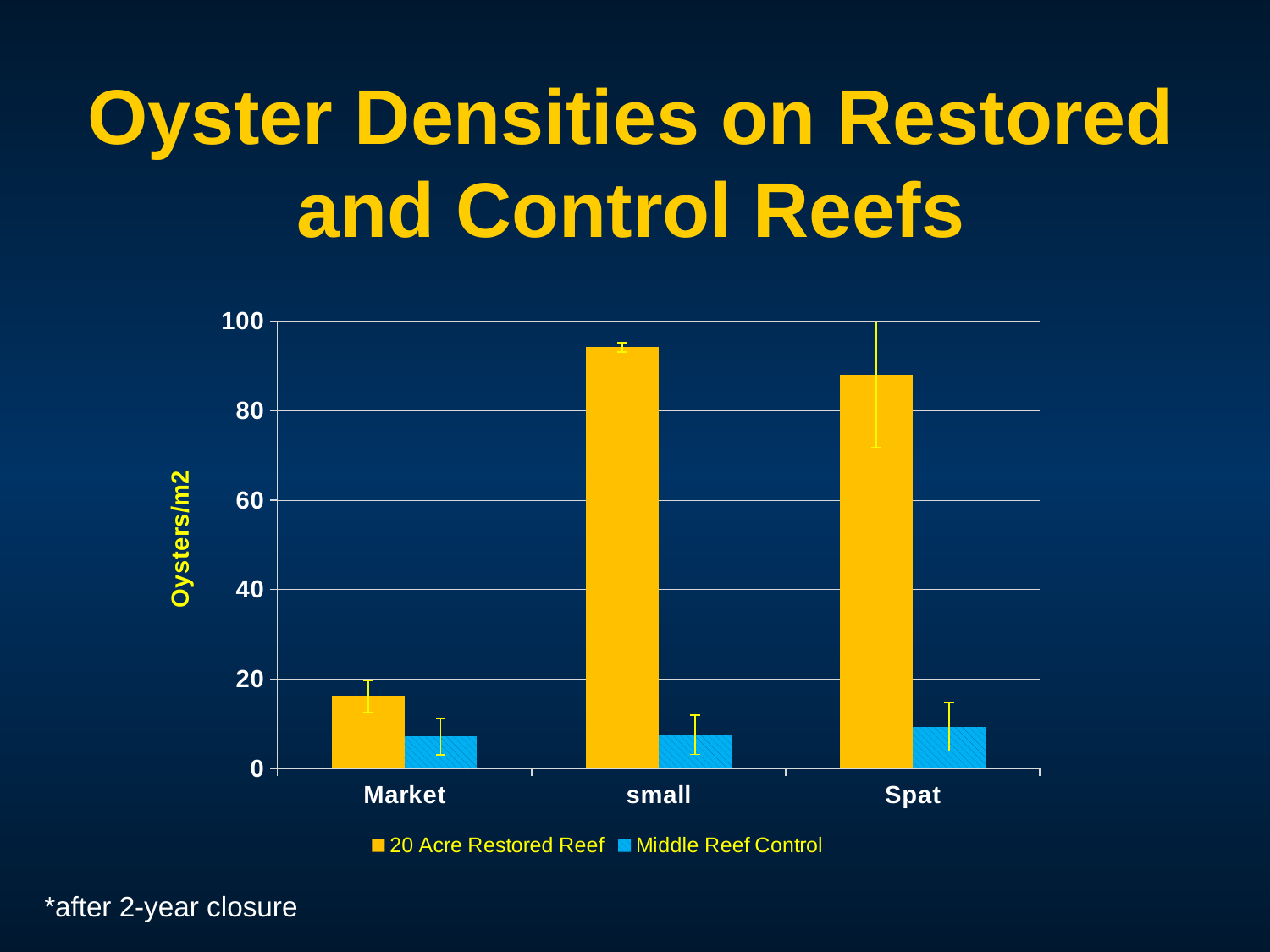
For the small category, which series has the larger value: 20 Acre Restored Reef or Middle Reef Control? 20 Acre Restored Reef Which category has the lowest value for the 20 Acre Restored Reef series? Market How many series does the chart's legend list? 2 What kind of chart is shown on the slide? bar chart Which category has the highest value for the 20 Acre Restored Reef series? small Is the 20 Acre Restored Reef value for Spat greater or less than 80? greater Is the Middle Reef Control value for Spat greater or less than 20? less What is the label on the vertical axis of the chart? Oysters/m2 Is the 20 Acre Restored Reef value for Market greater or less than 20? less What is the title of the slide's chart? Oyster Densities on Restored and Control Reefs How many categories are shown on the x axis of the chart? 3